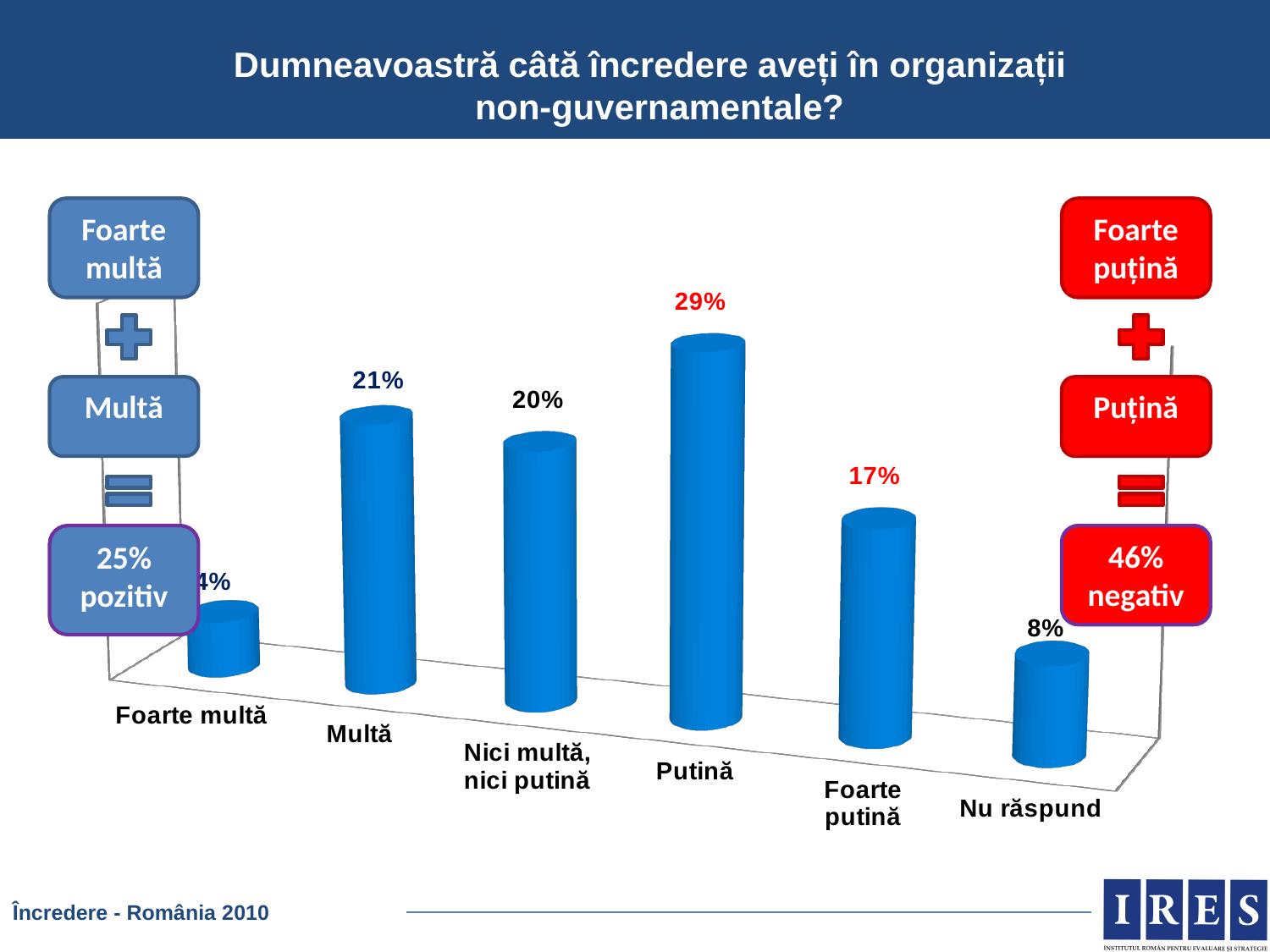
What percentage of respondents answered "Putină"? 29% Which is larger, the value for "Multă" or the value for "Nici multă, nici putină"? Multă What is the value for "Foarte putină"? 17% According to the summary box on the right, what is the combined negative share ("Foarte puțină" plus "Puțină")? 46% negativ What percentage is shown for "Nici multă, nici putină"? 20% What kind of chart is shown on the slide? Bar chart What is the difference between the values for "Putină" and "Foarte putină"? 12% What percentage of respondents are in the "Nu răspund" category? 8% What is the value shown for "Multă"? 21% How many categories are shown in the chart? 6 Which category has the lowest value? Foarte multă Which category has the highest value? Putină